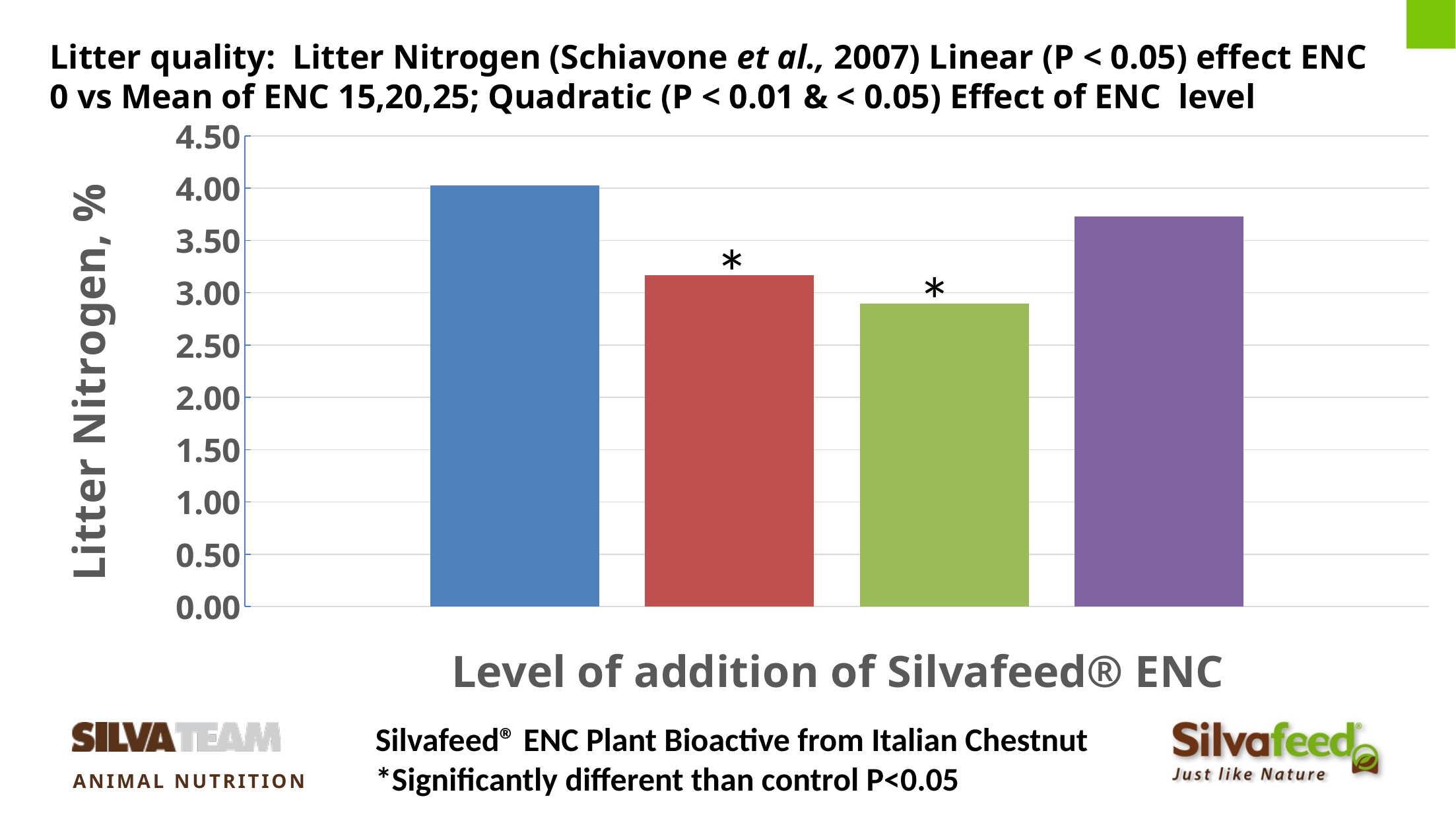
Is the value of the second (red) bar greater or less than 3.50? less What is the title of the y axis? Litter Nitrogen, % Which is larger, the first (blue) bar or the fourth (purple) bar? the first (blue) bar Is the value of the first (blue) bar greater or less than 3.50? greater How many bars are marked with an asterisk? 2 What kind of chart is shown on the slide? bar chart How many bars are plotted in the chart? 4 Which bar has the highest Litter Nitrogen value? the first (blue) bar Is the value of the third (green) bar greater or less than 2.50? greater Which is larger, the second (red) bar or the third (green) bar? the second (red) bar Which bar has the lowest Litter Nitrogen value? the third (green) bar